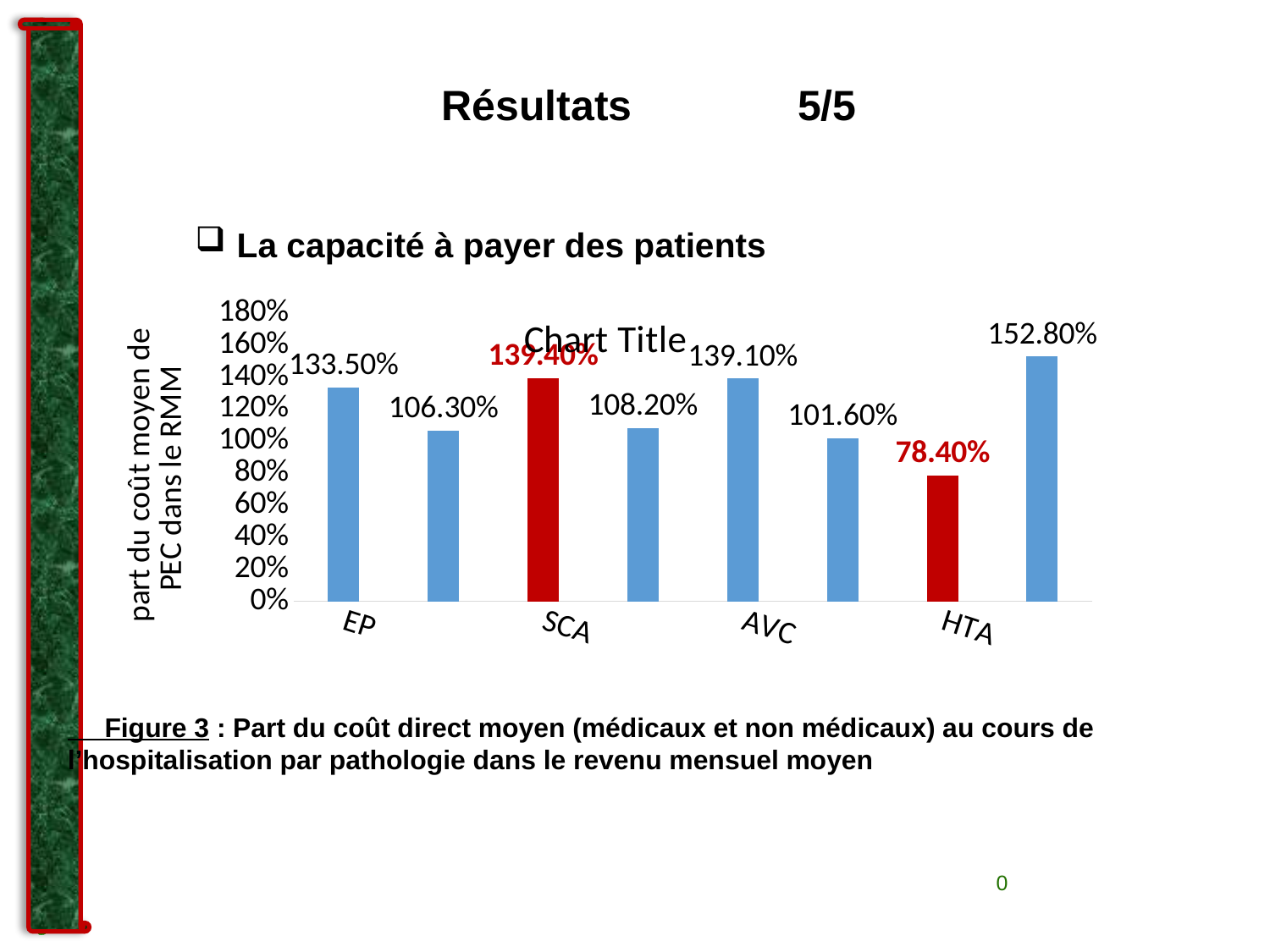
What is the highest data label value shown on the chart? 152.80% Is the value for HTA greater or less than 100%? less What is the value for EP? 133.50% What is the value for AVC? 139.10% Which labelled category has the lowest value? HTA What kind of chart is shown? bar chart Which is larger, the value for EP or the value for HTA? EP How many bars are coloured red? 2 What is the value for HTA? 78.40% What is the difference between the values for SCA and HTA? 61.00% How many bars are plotted on the chart? 8 What is the value for SCA? 139.40%